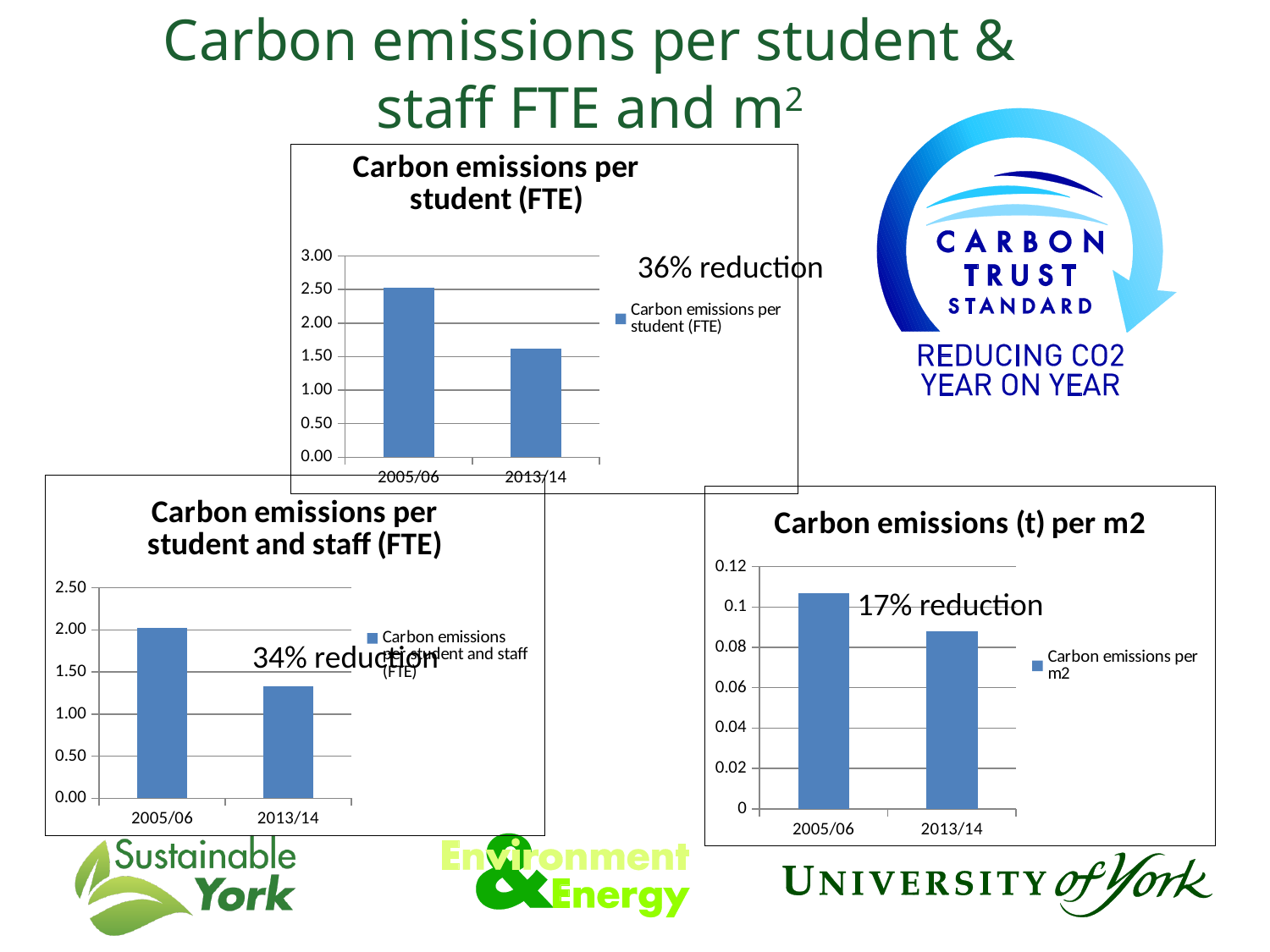
In the chart titled "Carbon emissions per student (FTE)", is the value for 2005/06 greater or less than 2.00? greater What kind of chart is the chart titled "Carbon emissions (t) per m2"? bar chart In the chart titled "Carbon emissions per student (FTE)", is the value for 2013/14 greater or less than 2.00? less How many categories are shown on the x axis of the chart titled "Carbon emissions per student (FTE)"? 2 In the chart titled "Carbon emissions per student and staff (FTE)", which year has the lower value? 2013/14 In the chart titled "Carbon emissions (t) per m2", is the value for 2005/06 greater or less than 0.1? greater What percentage reduction is annotated next to the chart titled "Carbon emissions (t) per m2"? 17% reduction In the chart titled "Carbon emissions (t) per m2", do the values rise or fall from 2005/06 to 2013/14? fall In the chart titled "Carbon emissions per student (FTE)", which year has the higher value? 2005/06